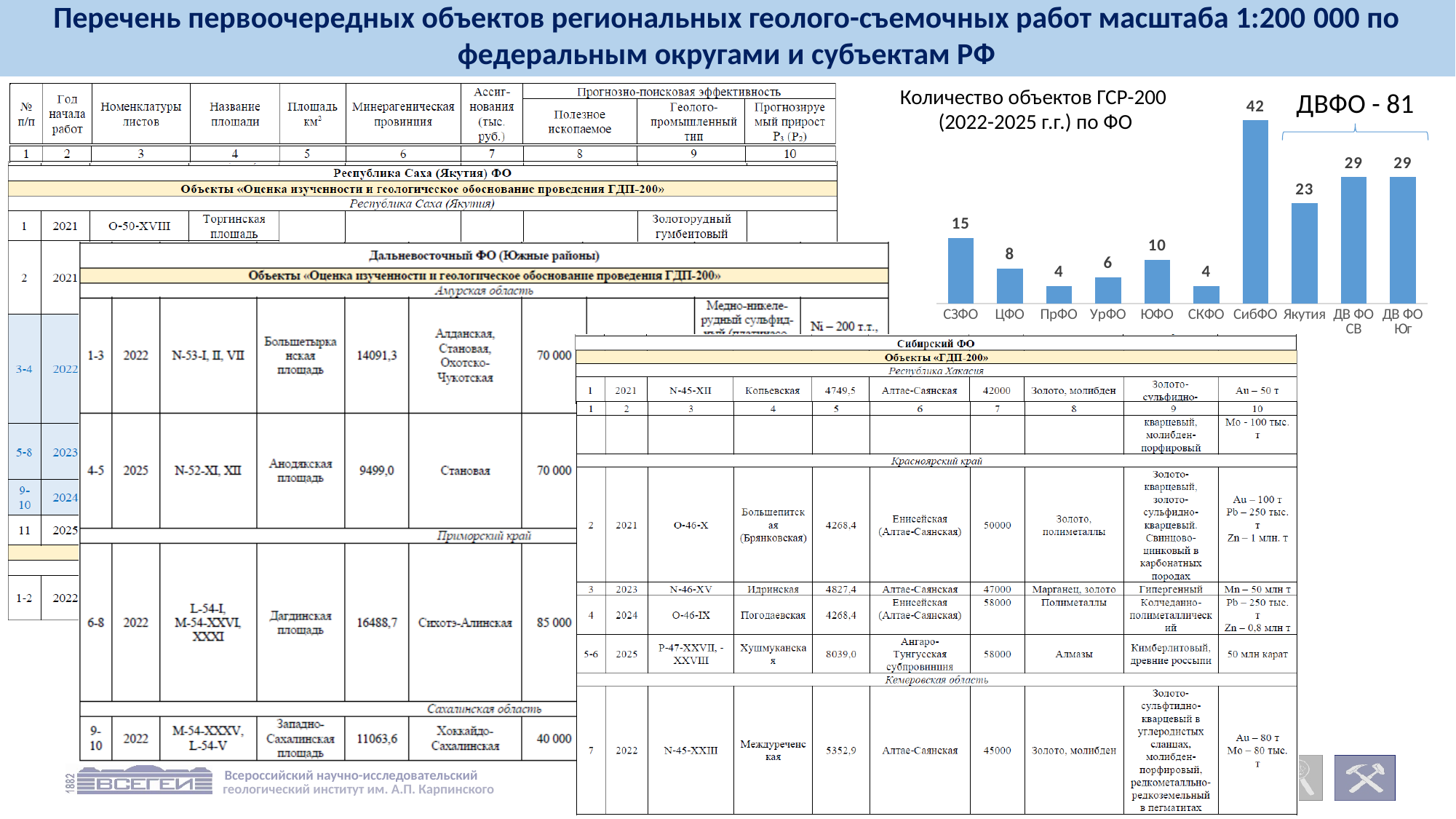
What is the value for СЗФО in the chart? 15 What is the title of the chart on the slide? Количество объектов ГСР-200 (2022-2025 г.г.) по ФО What is the combined value for Якутия, ДВ ФО СВ and ДВ ФО Юг, as annotated on the chart? 81 What is the value for СибФО in the chart 'Количество объектов ГСР-200 (2022-2025 г.г.) по ФО'? 42 What is the difference between the values for СибФО and Якутия? 19 Which two categories share the value 4 in the chart? ПрФО and СКФО What is the value for Якутия in the chart? 23 What kind of chart is shown on the slide? bar chart Which category has the highest value in the chart? СибФО What is the difference between the values for СЗФО and ЦФО? 7 Which is larger, the value for ЮФО or the value for УрФО? ЮФО How many categories are shown on the x axis of the chart? 10